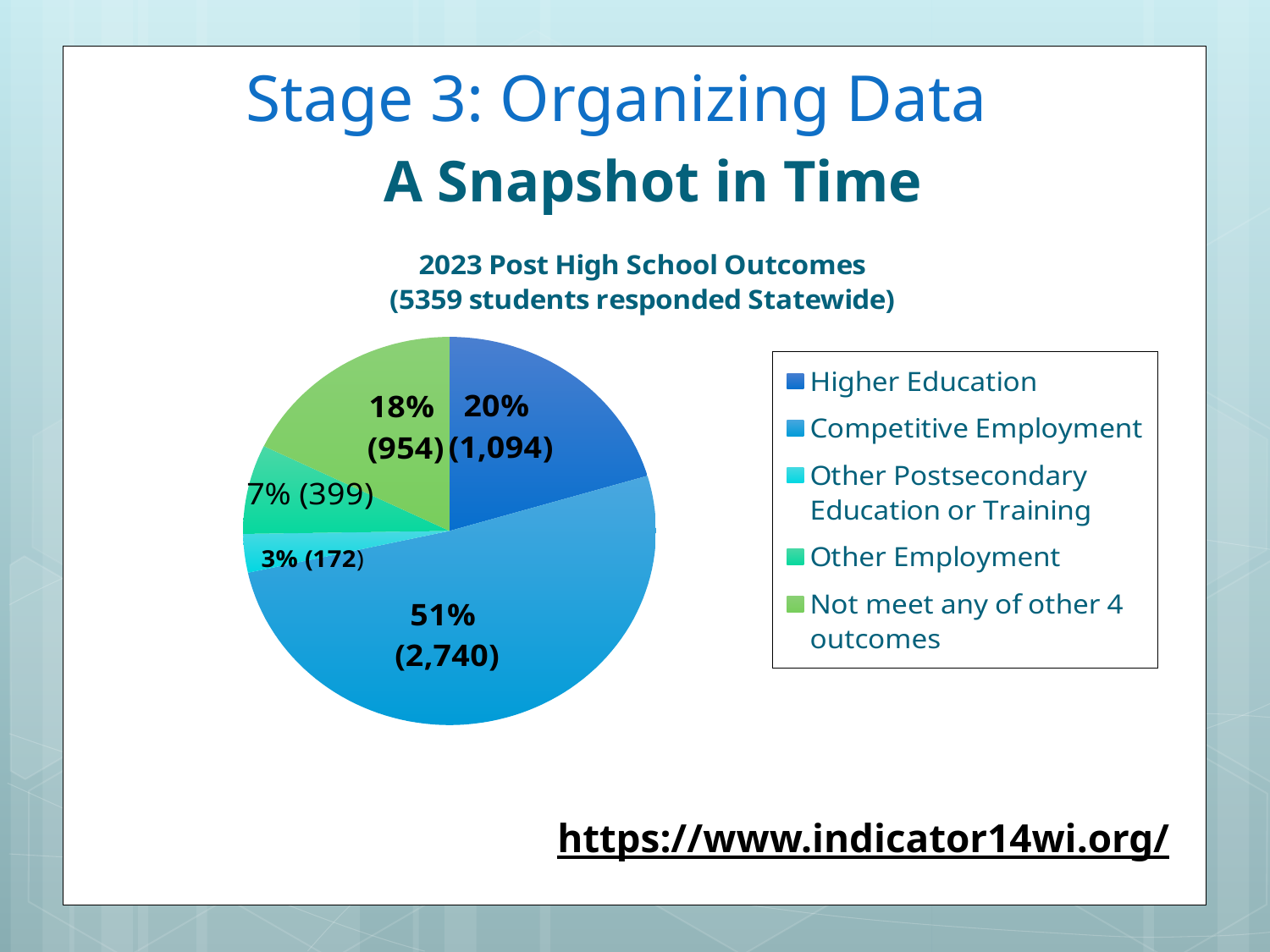
What kind of chart is shown on the slide? pie chart Which category has the smallest share of the pie? Other Postsecondary Education or Training Which is larger: Higher Education or Not meet any of other 4 outcomes? Higher Education How many categories does the legend list? 5 How many students are in the Other Employment category? 399 What percentage of students are in Competitive Employment? 51% What is the difference in number of students between Competitive Employment and Higher Education? 1,646 Which category has the largest share of the pie? Competitive Employment What percentage of students are in Other Postsecondary Education or Training? 3% How many slices does the pie chart have? 5 What is the title of the chart? 2023 Post High School Outcomes (5359 students responded Statewide) How many students are in the Higher Education category? 1,094